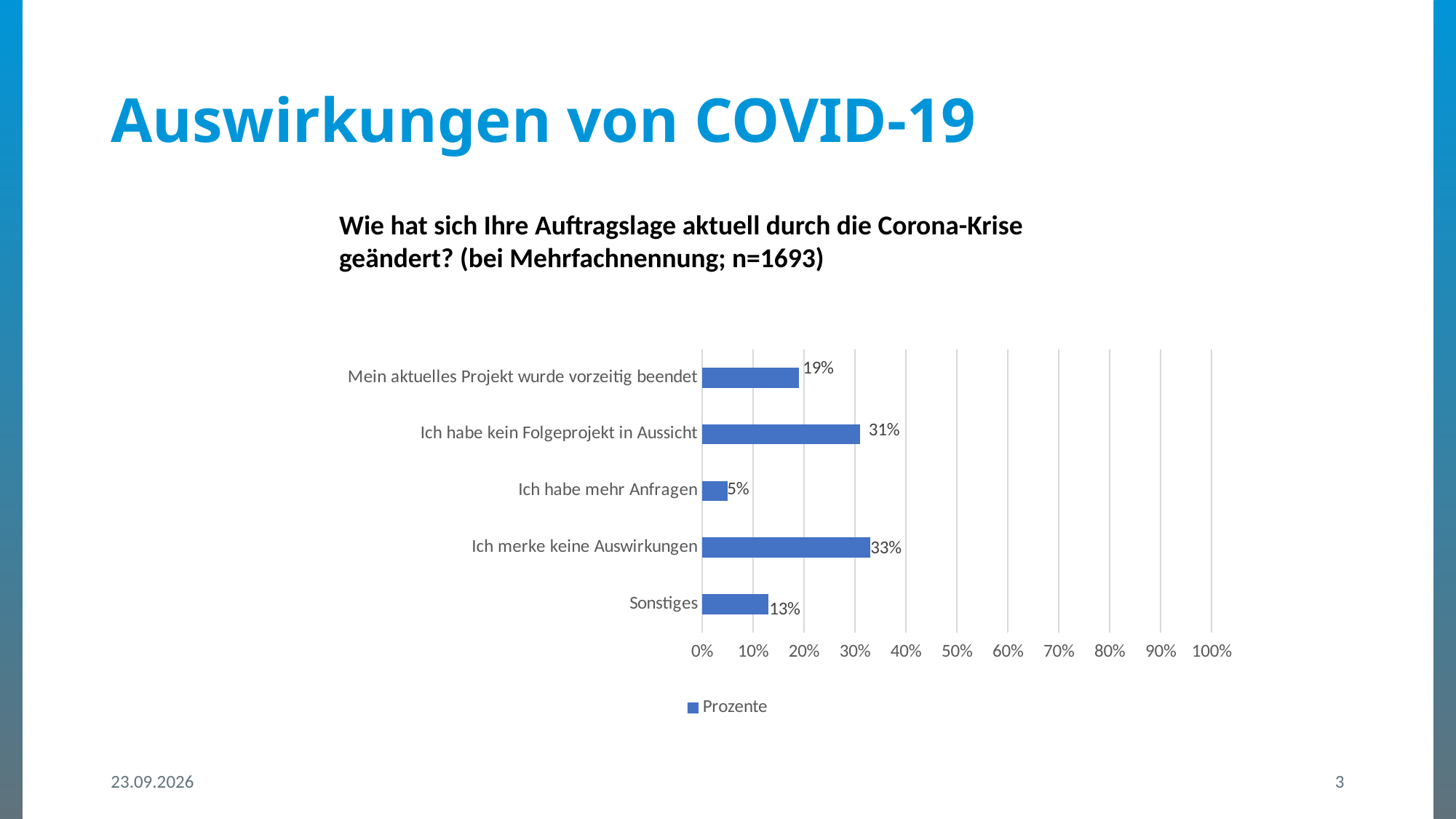
What is the difference between the values for "Ich merke keine Auswirkungen" and "Ich habe mehr Anfragen"? 28% Is the value for "Ich habe kein Folgeprojekt in Aussicht" greater or less than 40%? less How many categories are shown in the chart? 5 What is the value for "Ich habe kein Folgeprojekt in Aussicht"? 31% Which category has the lowest value? Ich habe mehr Anfragen Which category has the highest value? Ich merke keine Auswirkungen What kind of chart is shown on the slide? bar chart What is the name of the series shown in the legend? Prozente Which is larger: the value for "Mein aktuelles Projekt wurde vorzeitig beendet" or the value for "Sonstiges"? Mein aktuelles Projekt wurde vorzeitig beendet What is the value for "Sonstiges"? 13% What is the value for "Mein aktuelles Projekt wurde vorzeitig beendet"? 19% How many series does the legend list? 1